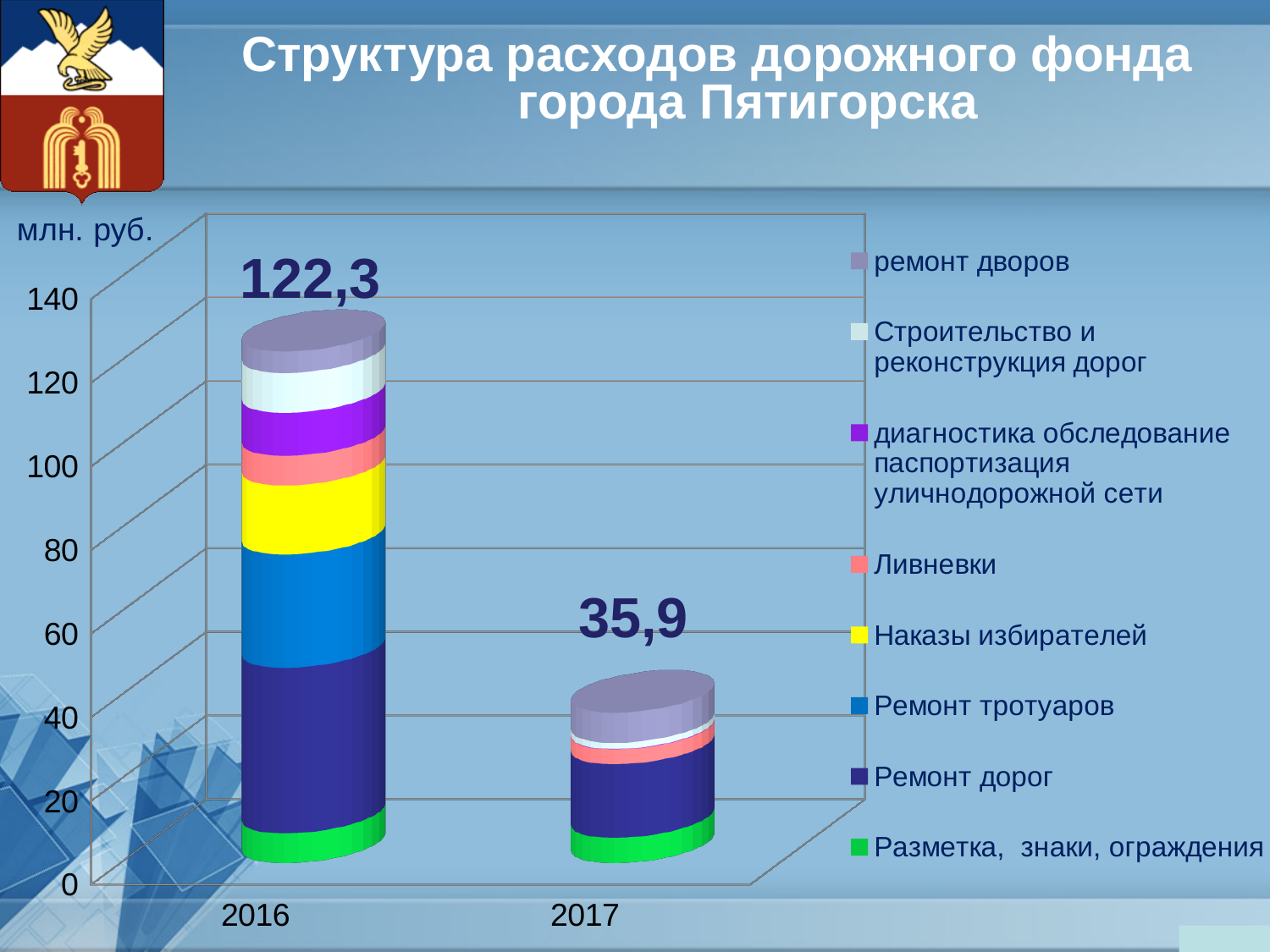
Is the total for 2016 larger or smaller than the total for 2017? larger How many series does the legend list? 8 Do the totals rise or fall from 2016 to 2017? fall What is the total value shown for 2017? 35,9 How many years (categories) are shown on the x axis? 2 Which legend entry is shown in yellow? Наказы избирателей What is the total value shown for 2016? 122,3 What kind of chart is shown on the slide? stacked bar chart What unit is indicated for the values on the chart? млн. руб. What is the difference between the 2016 total and the 2017 total? 86,4 Which year has the lower total expenditure? 2017 Which year has the higher total expenditure? 2016